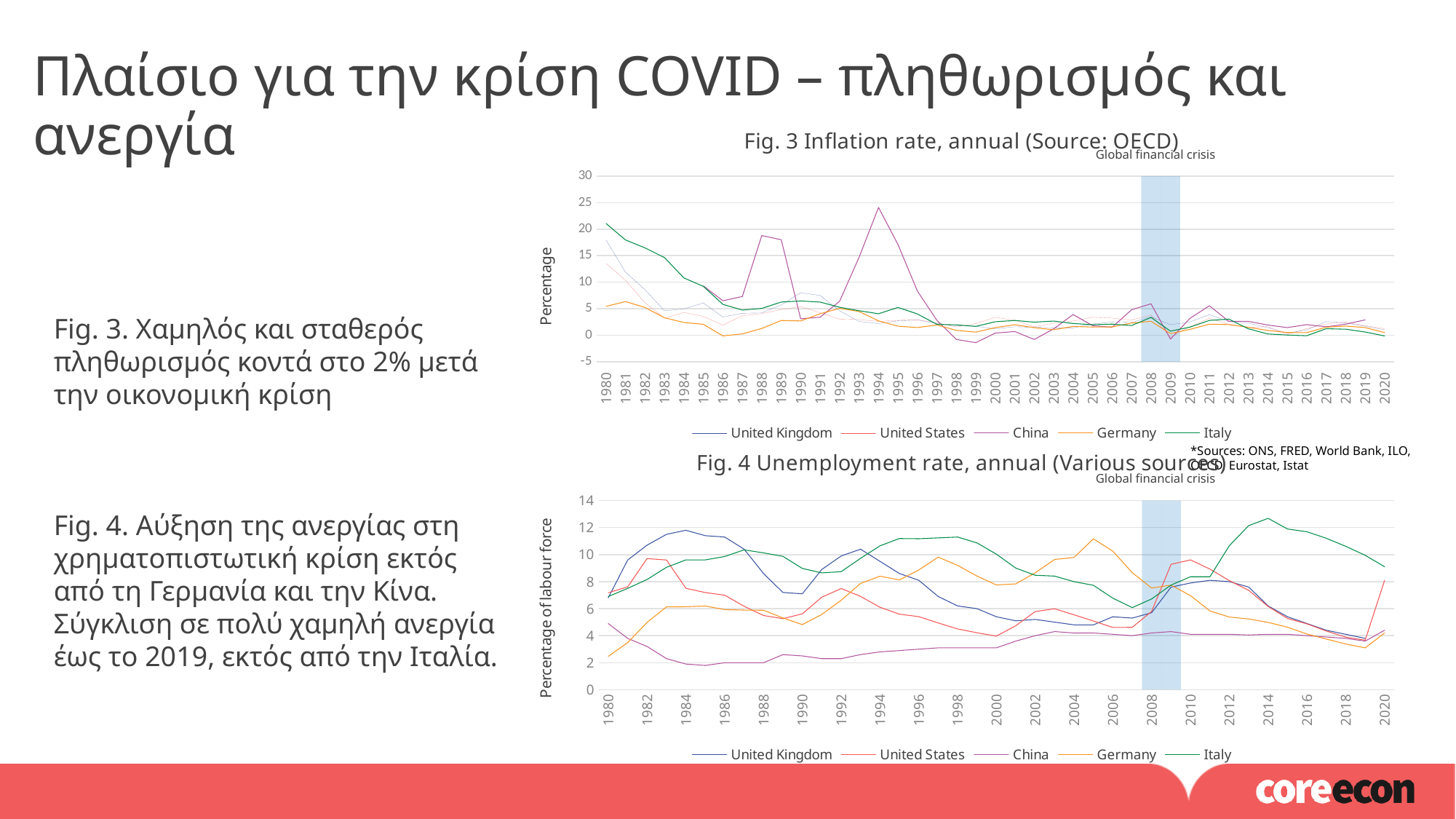
In Fig. 4 Unemployment rate, annual, which country has the lowest unemployment rate in 1985? China How many series does the legend of Fig. 4 Unemployment rate, annual list? 5 In Fig. 3 Inflation rate, annual, does the inflation rate for Italy rise or fall overall from 1980 to 2020? fall In Fig. 3 Inflation rate, annual, which country reaches the highest inflation rate shown on the chart? China In Fig. 4 Unemployment rate, annual, is the value for China in 1984 greater or less than 4? less What is the y-axis label of Fig. 4 Unemployment rate, annual? Percentage of labour force In Fig. 4 Unemployment rate, annual, is the value for Italy in 2014 greater or less than 10? greater In Fig. 4 Unemployment rate, annual, which is larger in 2014: the value for Italy or the value for Germany? Italy In Fig. 3 Inflation rate, annual, is the value for China in 1994 greater or less than 20? greater In Fig. 4 Unemployment rate, annual, which country has the highest unemployment rate in 2014? Italy What kind of chart is Fig. 3 Inflation rate, annual? line chart